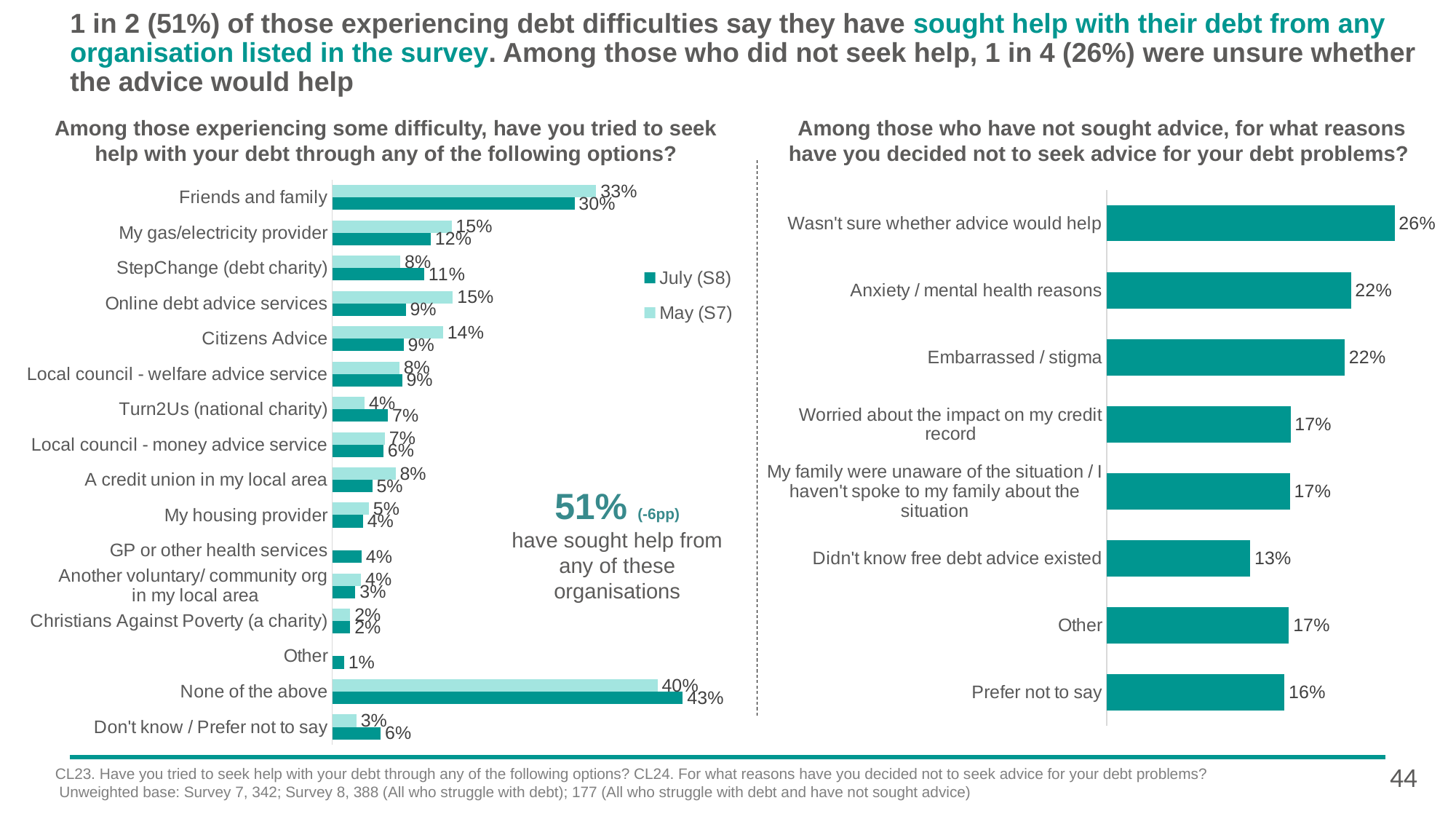
In the right chart (reasons for not seeking advice), which reason has the lowest value? Didn't know free debt advice existed In the right chart (reasons for not seeking advice), what is the value for Prefer not to say? 16% In the right chart (reasons for not seeking advice), which reason has the highest value? Wasn't sure whether advice would help In the left chart (seeking help with debt), what is the May (S7) value for Online debt advice services? 15% What type of chart is the right chart (reasons for not seeking advice)? Bar chart In the left chart (seeking help with debt), which category has the lowest July (S8) value? Other In the left chart (seeking help with debt), what is the July (S8) value for Friends and family? 30% In the left chart (seeking help with debt), how many series does the legend list? 2 In the left chart (seeking help with debt), which is larger for StepChange (debt charity): the July (S8) value or the May (S7) value? July (S8) In the left chart (seeking help with debt), what is the July (S8) value for None of the above? 43% In the right chart (reasons for not seeking advice), how many reasons are shown? 8 In the left chart (seeking help with debt), what is the difference between the May (S7) and July (S8) values for Citizens Advice? 5 percentage points